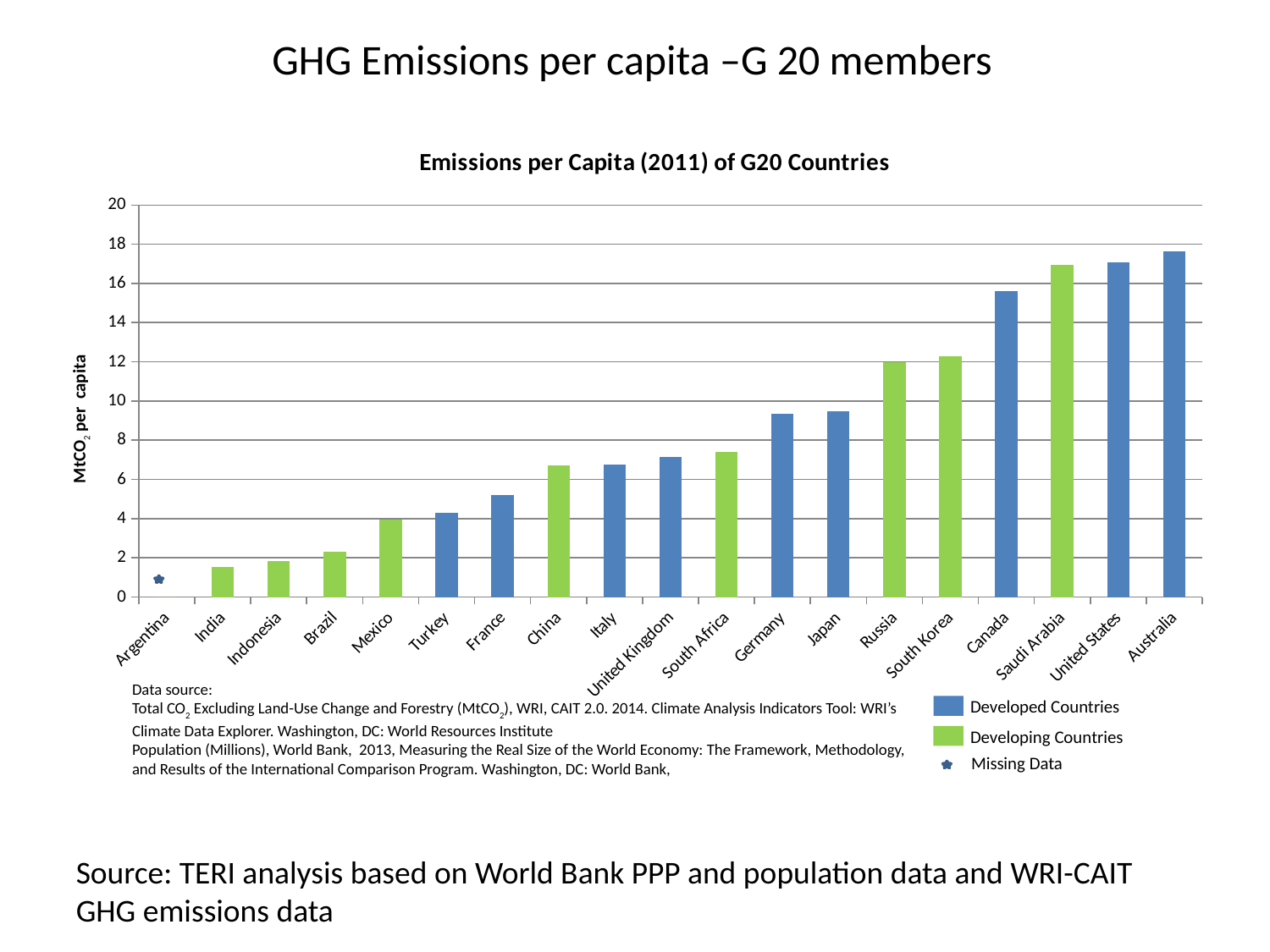
Is the value for Russia greater or less than 14? less Do the values generally rise or fall from left to right along the x axis? rise How many entries does the chart's legend list? 3 Which has the larger value, France or China? China What kind of chart is shown on the slide? bar chart Is the value for Germany greater or less than 8? greater How many countries are shown along the x axis of the chart? 19 Is the value for Brazil greater or less than 4? less Which country has the highest emissions per capita in the chart? Australia Which has the larger value, Canada or Saudi Arabia? Saudi Arabia